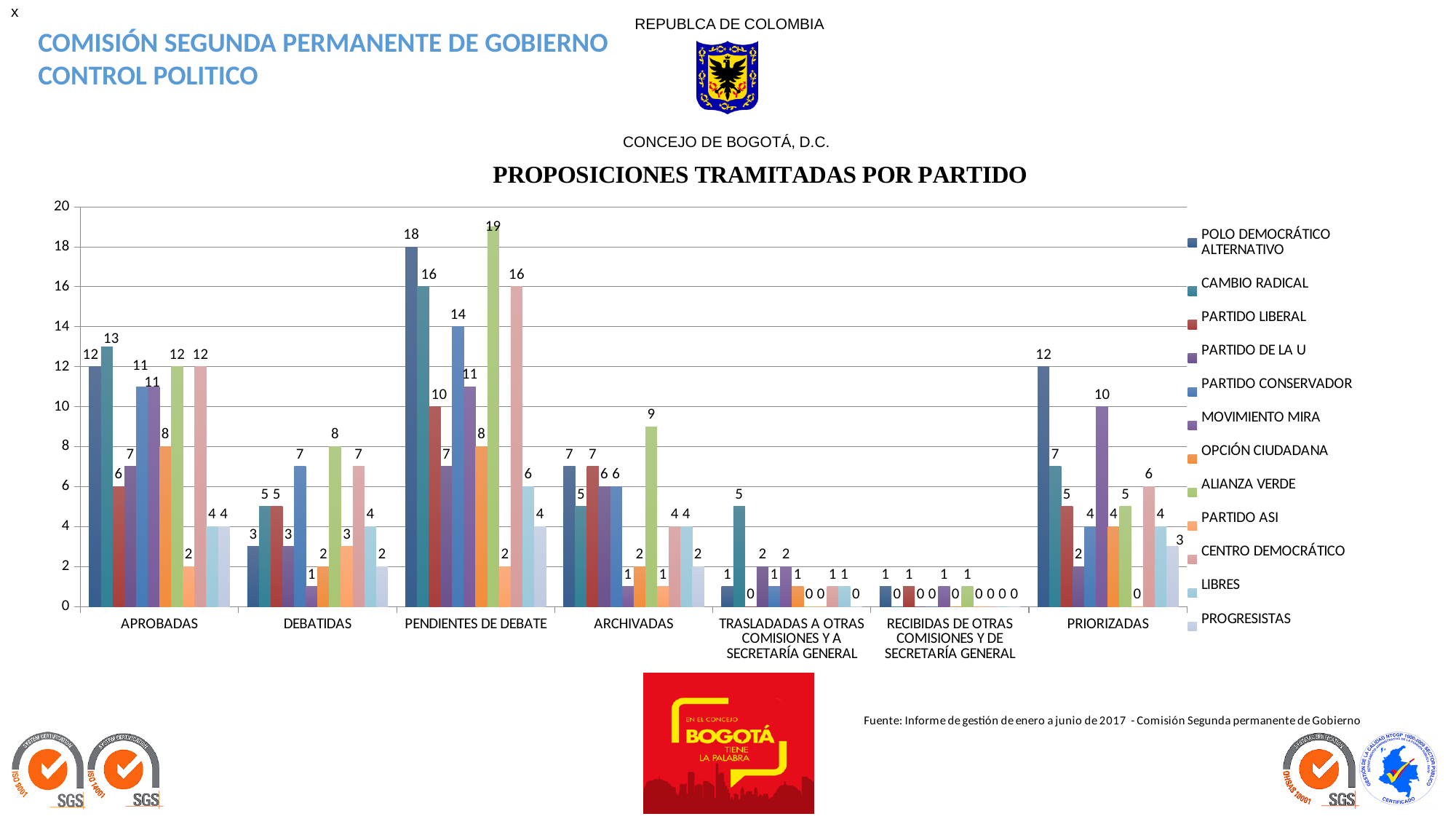
What is the value for MOVIMIENTO MIRA in the PRIORIZADAS category? 10 What is the value for CAMBIO RADICAL in the APROBADAS category? 13 What kind of chart is this? Bar chart What is the title of the chart? PROPOSICIONES TRAMITADAS POR PARTIDO What is the value for ALIANZA VERDE in the PENDIENTES DE DEBATE category? 19 How many categories are shown on the x axis? 7 Which party has the lowest value in the APROBADAS category? PARTIDO ASI What is the difference between POLO DEMOCRÁTICO ALTERNATIVO and CAMBIO RADICAL in the PENDIENTES DE DEBATE category? 2 Which party has the highest value in the PENDIENTES DE DEBATE category? ALIANZA VERDE What is the value for POLO DEMOCRÁTICO ALTERNATIVO in the PRIORIZADAS category? 12 In the ARCHIVADAS category, which is larger: ALIANZA VERDE or PARTIDO LIBERAL? ALIANZA VERDE How many series does the legend list? 12